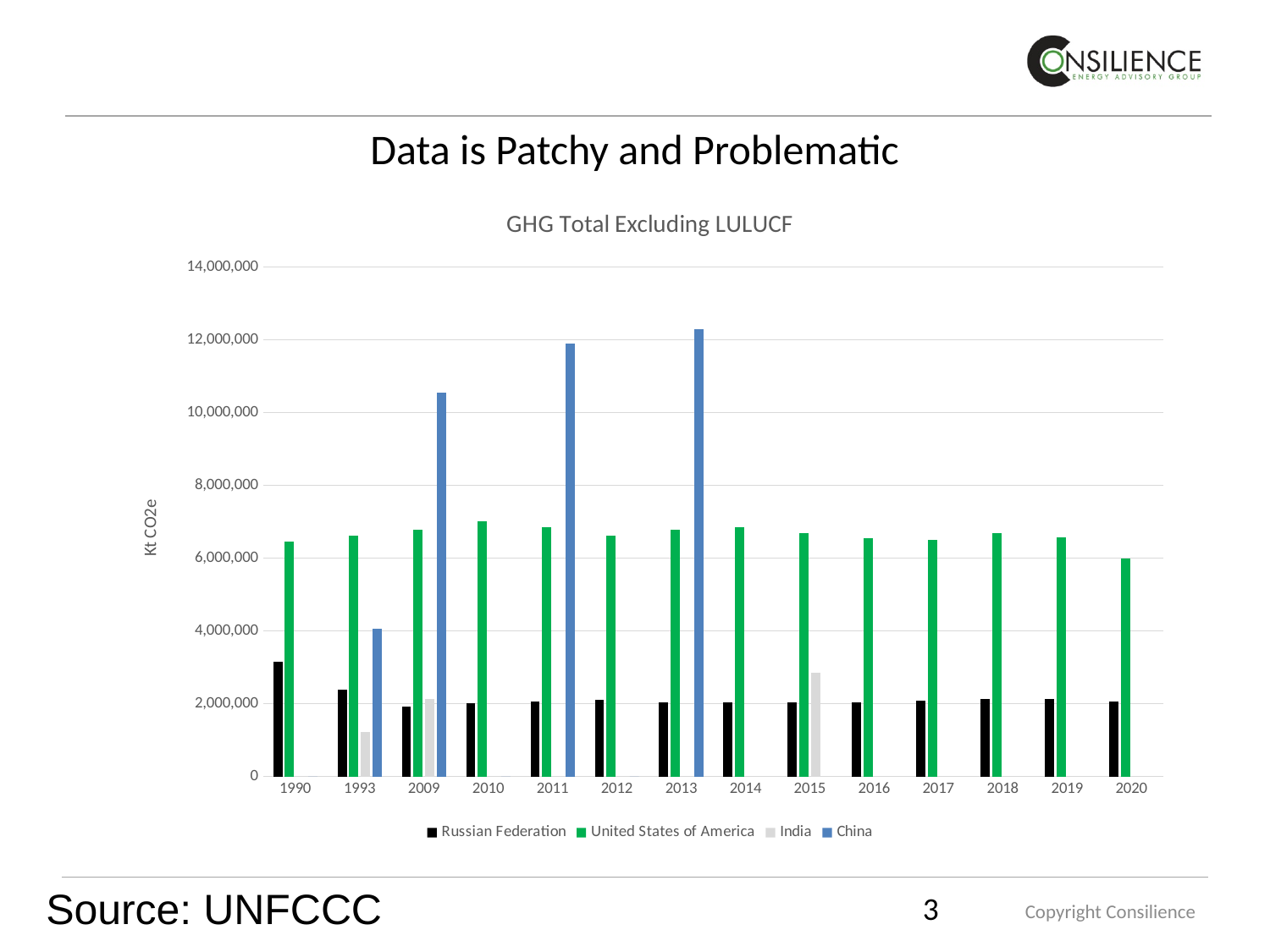
Which series has the tallest bar in the chart? China Which is larger in 2013, the value for China or the value for the United States of America? China Which is larger for the Russian Federation, the value in 1990 or the value in 2020? 1990 How many series does the legend list? 4 What is the label on the vertical axis? Kt CO2e What kind of chart is shown on the slide? bar chart How many years are shown on the x axis? 14 Is the value for India in 1993 greater or less than 2,000,000? less Is the value for China in 2009 greater or less than 10,000,000? greater In which year does China have its highest bar? 2013 What is the title of the chart? GHG Total Excluding LULUCF Is the value for China in 2013 greater or less than 12,000,000? greater